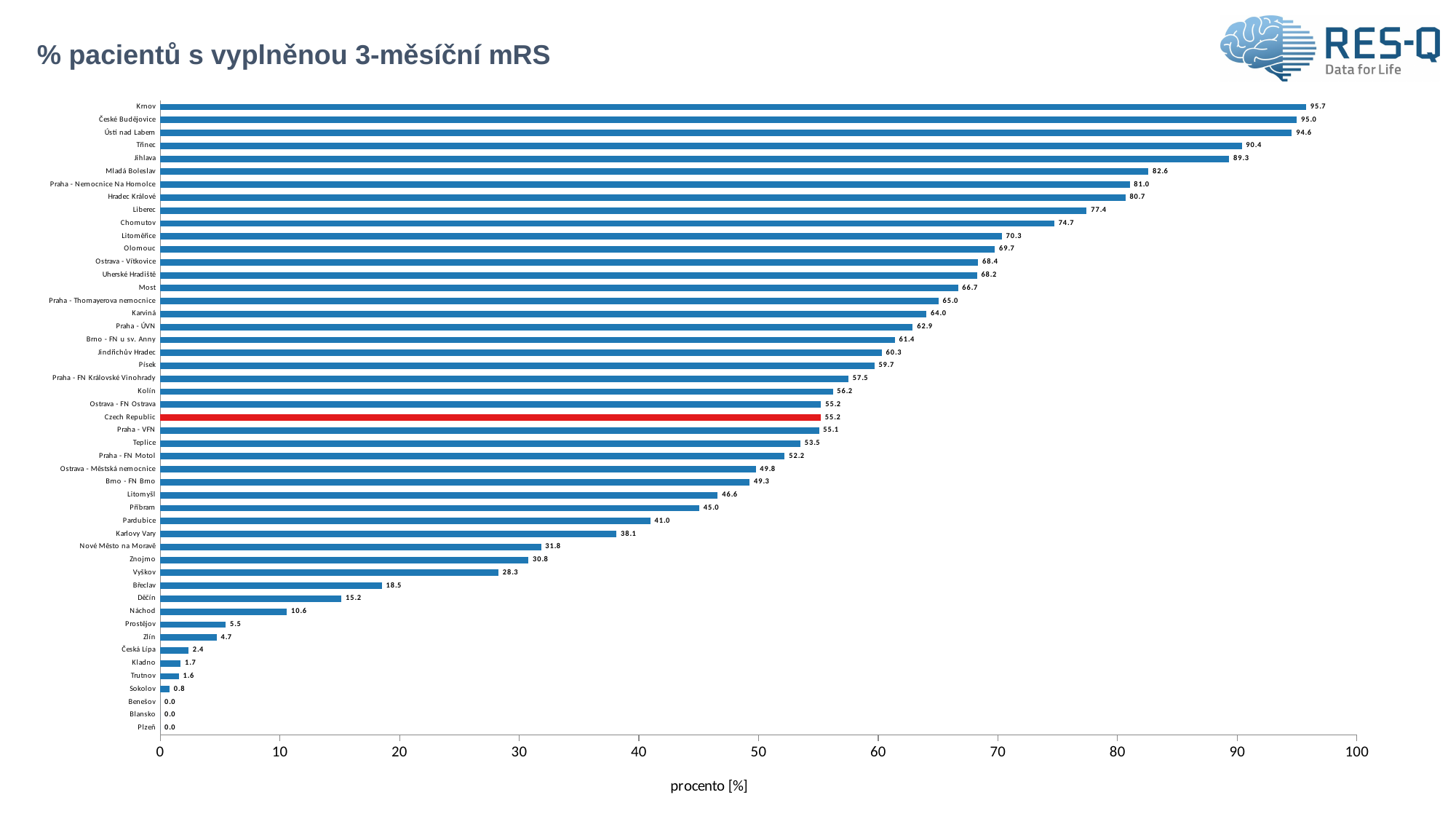
Which bar is coloured red instead of blue? Czech Republic Which category has the highest value? Krnov Is the value for Karlovy Vary greater or less than 40? less What is the value for Náchod? 10.6 What is the value for Praha - FN Motol? 52.2 What is the difference between the values for Czech Republic and Pardubice? 14.2 What is the difference between the values for Krnov and Jihlava? 6.4 What is the title of the chart? % pacientů s vyplněnou 3-měsíční mRS What is the value for Czech Republic? 55.2 What kind of chart is shown on the slide? bar chart Which is larger, the value for Liberec or the value for Chomutov? Liberec What is the value for Krnov? 95.7